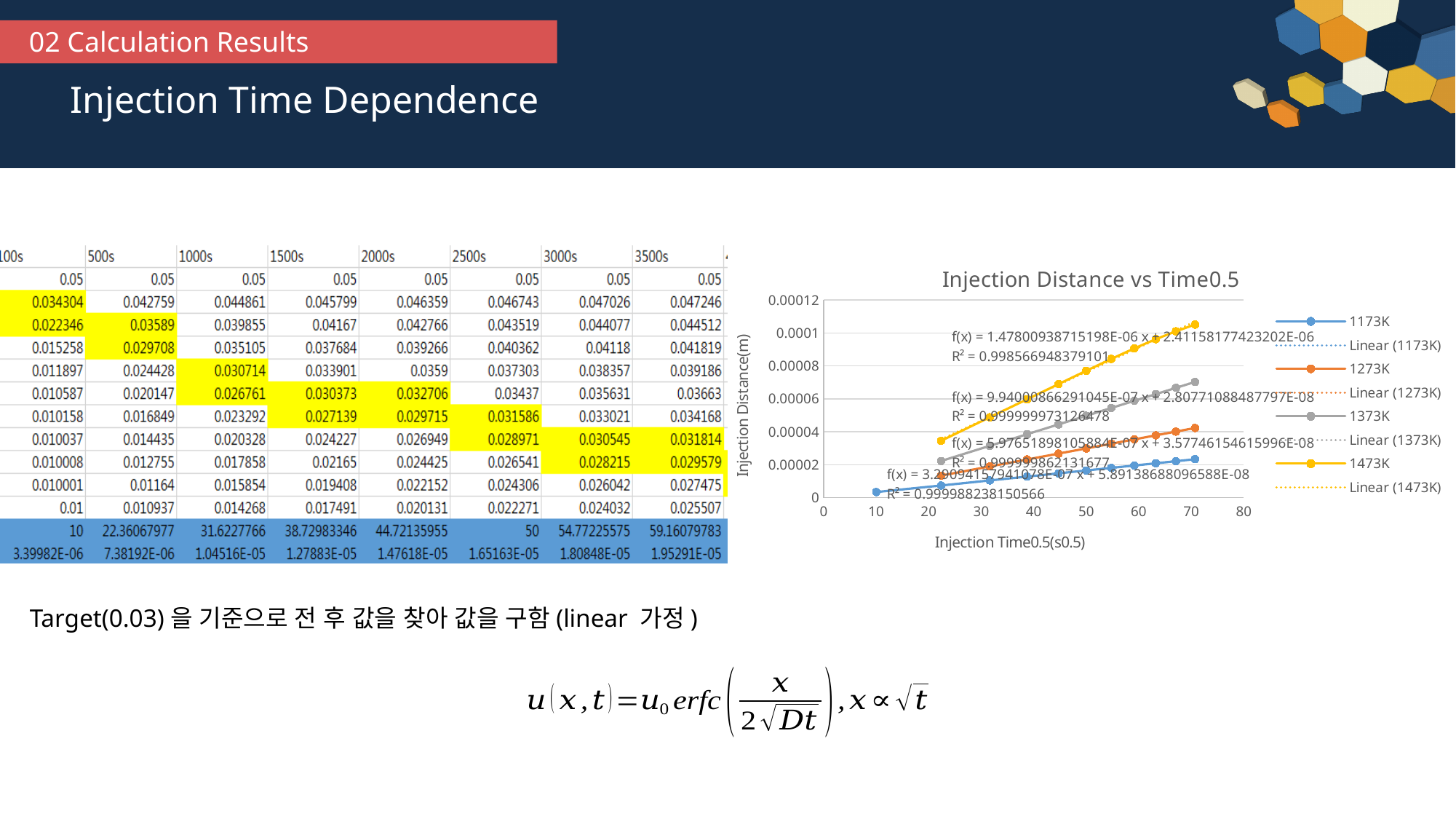
How many entries does the chart legend list? 8 Which temperature series reaches the highest injection distance on the chart? 1473K Which temperature series has the lowest injection distance values on the chart? 1173K What is the x-axis title of the chart? Injection Time0.5(s0.5) At Injection Time0.5 of about 70, which series has the larger injection distance, 1373K or 1273K? 1373K What type of chart is shown on the slide? Line chart (scatter with lines) At Injection Time0.5 of about 70, which series has the larger injection distance, 1473K or 1173K? 1473K Is the value of the 1473K series at Injection Time0.5 of about 50 greater or less than 0.00006? greater Do the injection distance values rise or fall as Injection Time0.5 increases? Rise What is the title of the chart? Injection Distance vs Time0.5 Is the highest value of the 1273K series greater or less than 0.00006? less Is the highest value of the 1173K series greater or less than 0.00004? less